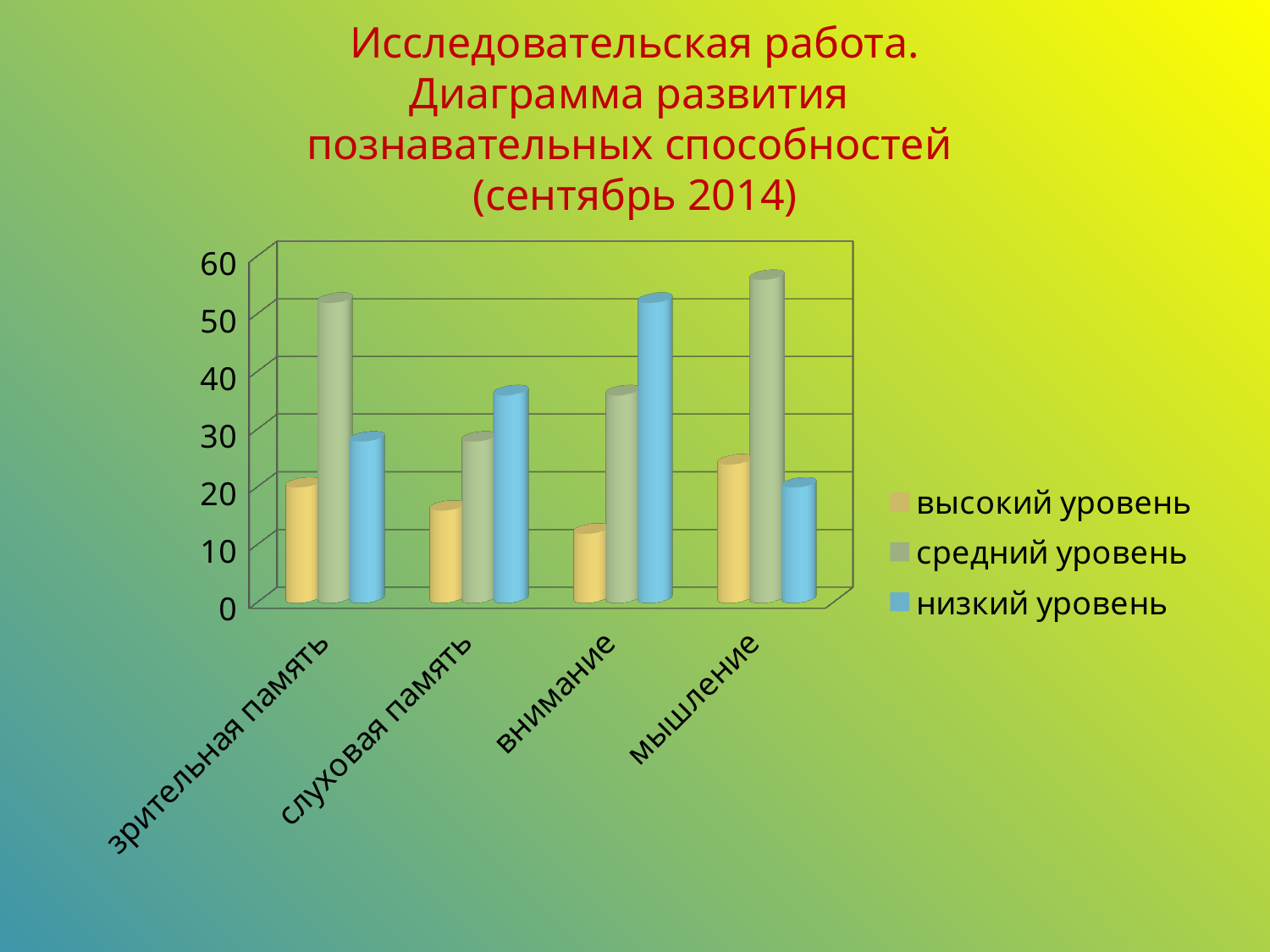
Which legend entry is shown in blue? низкий уровень Is the value for низкий уровень in внимание greater or less than 40? greater Is the value for средний уровень in мышление greater or less than 50? greater Is the value for высокий уровень in внимание greater or less than 20? less Which category has the highest value for низкий уровень? внимание What kind of chart is shown on the slide? bar chart How many categories are shown on the x axis of the chart? 4 How many series does the chart's legend list? 3 In зрительная память, which is larger: средний уровень or низкий уровень? средний уровень Which category has the lowest value for высокий уровень? внимание